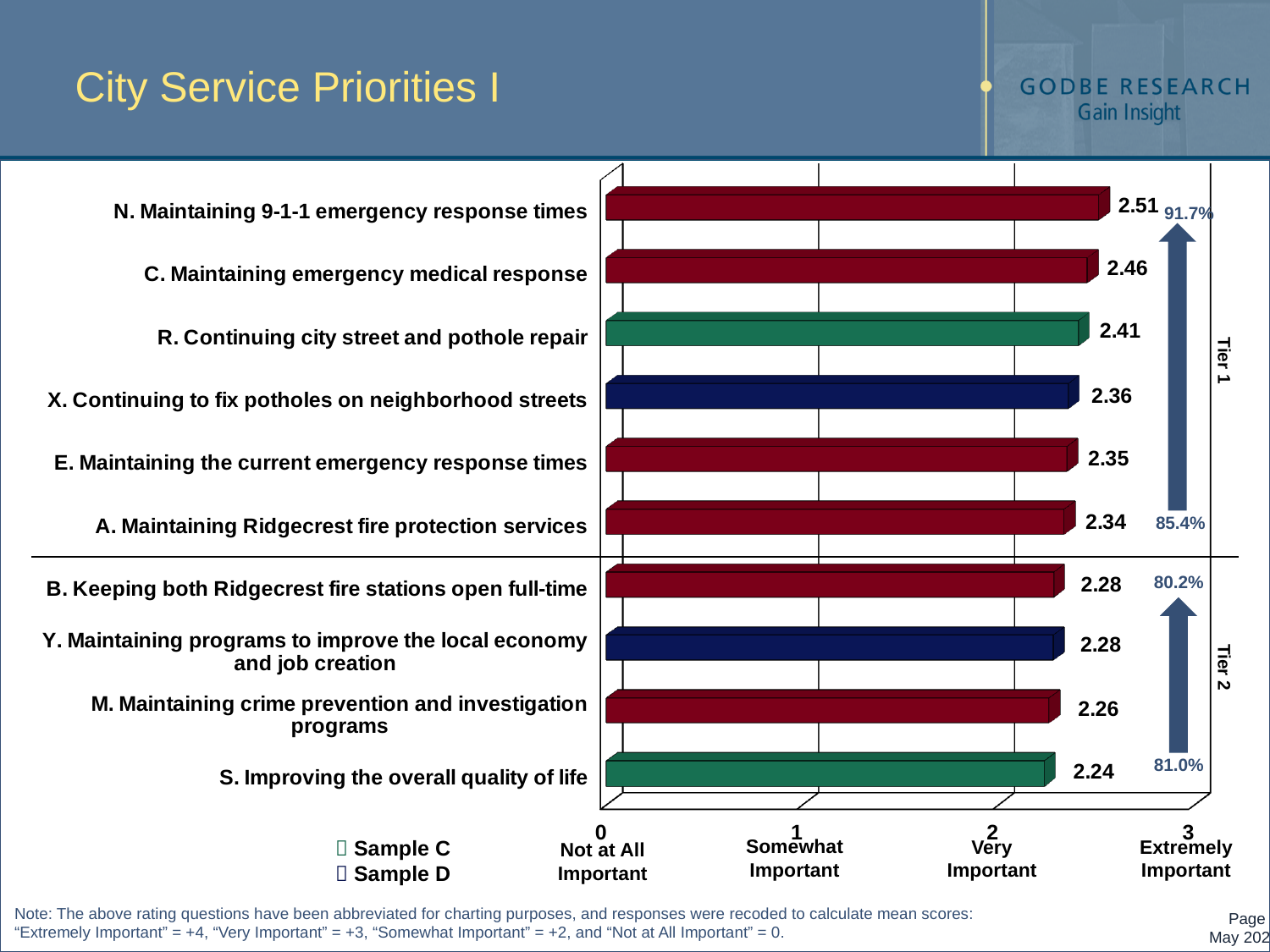
What is the mean score for "N. Maintaining 9-1-1 emergency response times"? 2.51 Which city service has the lowest mean score? S. Improving the overall quality of life What kind of chart is shown on the slide? Bar chart What is the difference between the mean scores for "C. Maintaining emergency medical response" and "R. Continuing city street and pothole repair"? 0.05 Is the value for "M. Maintaining crime prevention and investigation programs" greater or less than 2? greater What is the difference between the mean scores for "N. Maintaining 9-1-1 emergency response times" and "S. Improving the overall quality of life"? 0.27 Which city service has the highest mean score? N. Maintaining 9-1-1 emergency response times What is the mean score for "R. Continuing city street and pothole repair"? 2.41 Which has a higher mean score: "R. Continuing city street and pothole repair" or "X. Continuing to fix potholes on neighborhood streets"? R. Continuing city street and pothole repair How many city services are plotted on the chart? 10 What is the mean score for "S. Improving the overall quality of life"? 2.24